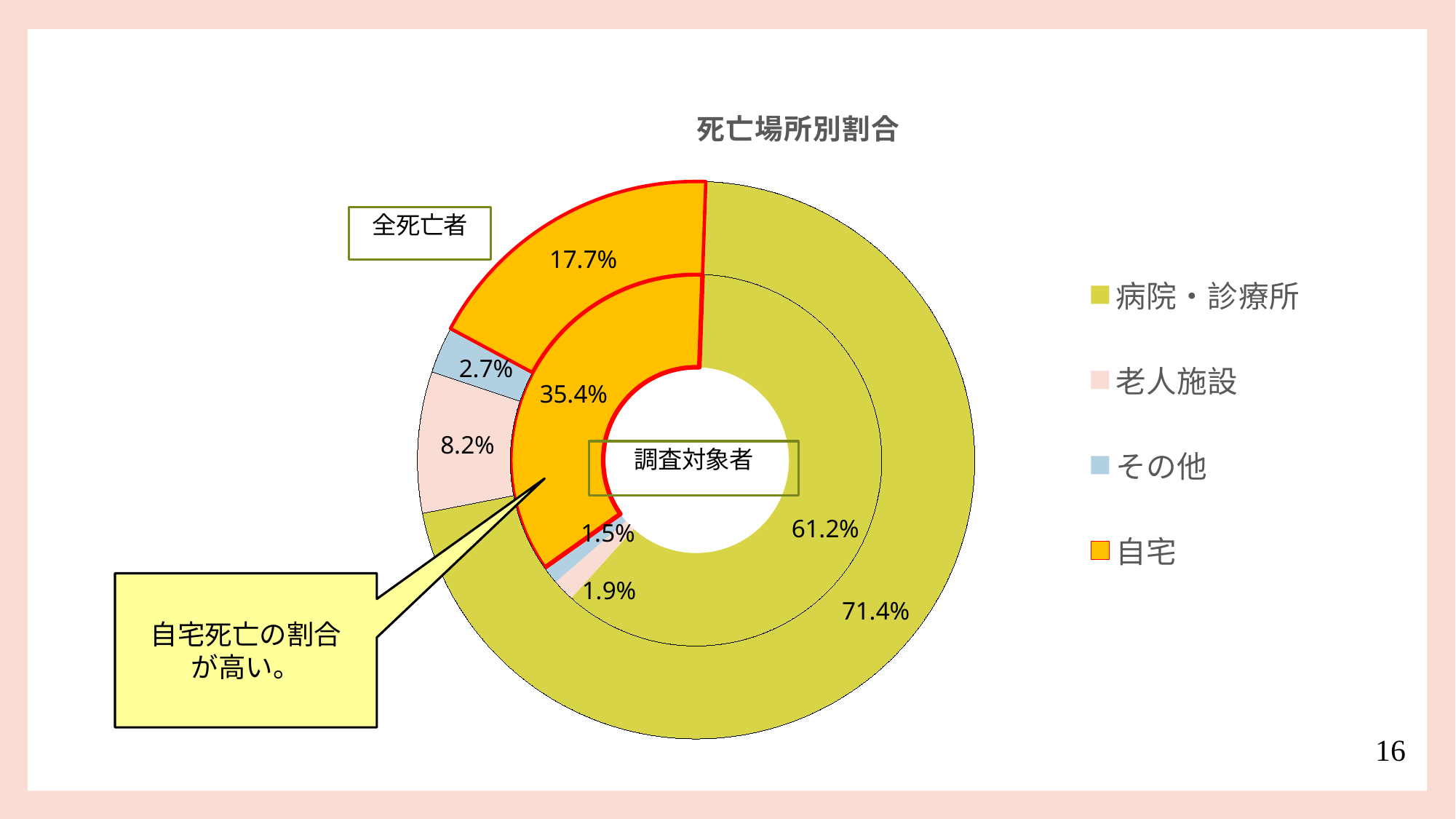
In the 全死亡者 (outer) ring, what is the share for その他? 2.7% Which category has the smallest share in the 調査対象者 (inner) ring? その他 Which category has the largest share in the 調査対象者 (inner) ring? 病院・診療所 In the 調査対象者 (inner) ring, what is the share for 老人施設? 1.9% Which is larger: the 老人施設 share in the 全死亡者 ring or in the 調査対象者 ring? 全死亡者 In the 全死亡者 (outer) ring, what is the share for 自宅? 17.7% What kind of chart is shown on the slide? doughnut chart What is the difference between the 自宅 share in the 調査対象者 ring (35.4%) and in the 全死亡者 ring (17.7%)? 17.7% What is the title of the chart? 死亡場所別割合 How many categories does the legend list? 4 In the 調査対象者 (inner) ring, what is the share for 自宅? 35.4% In the 全死亡者 (outer) ring, what is the share for 病院・診療所? 71.4%